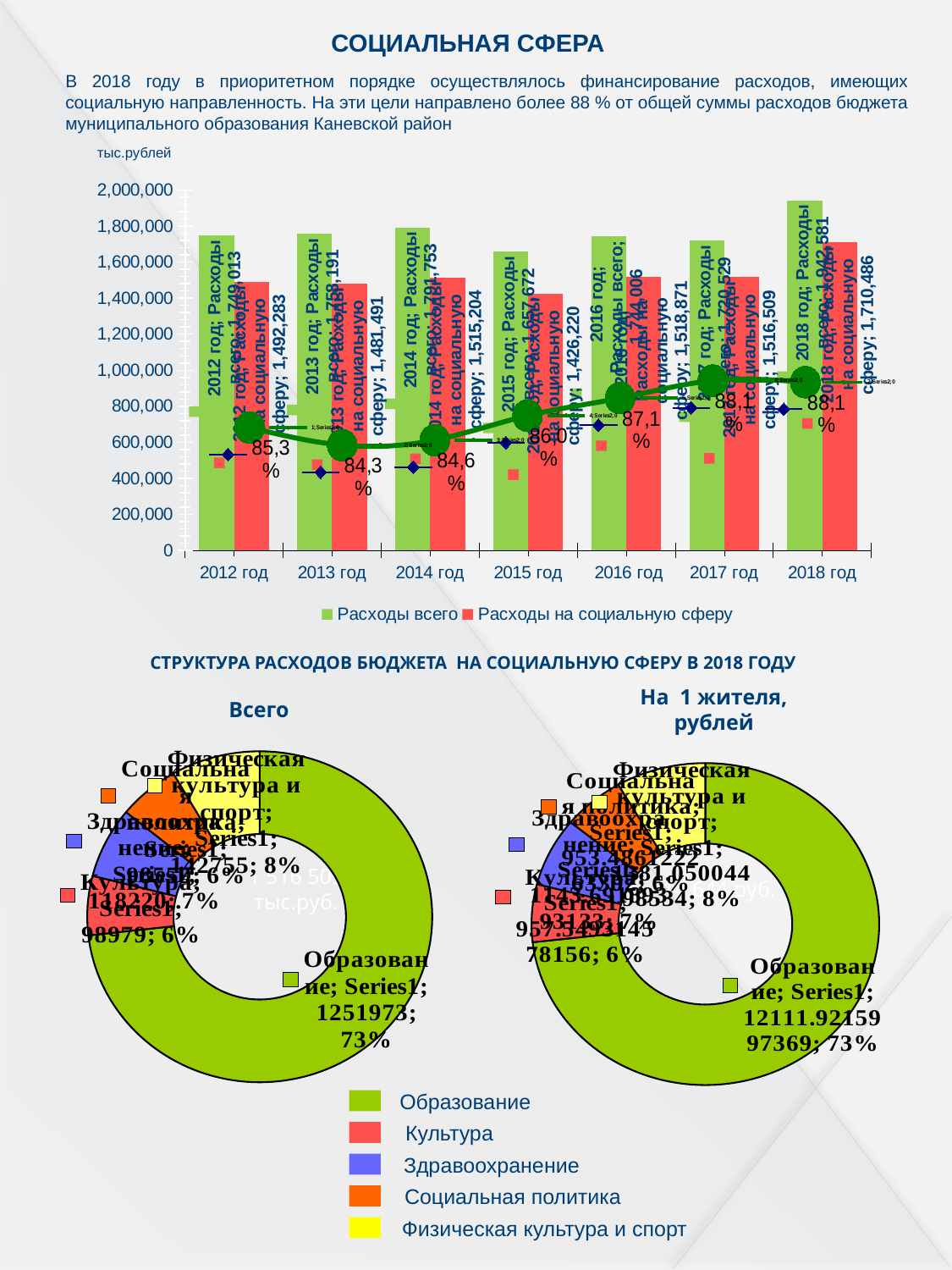
In the 'Всего' donut chart at the bottom left, what share does Образование have? 73% In the top bar chart, which year has the lowest value for Расходы всего? 2015 год In the top bar chart, what is the value of Расходы на социальную сферу for 2015 год? 1,426,220 In the top bar chart, what is the value of Расходы на социальную сферу for 2018 год? 1,710,486 In the top bar chart, does the percentage line rise or fall from 2014 год to 2018 год? rise In the top bar chart, which year has the highest value for Расходы всего? 2018 год In the top bar chart, which is larger: Расходы всего for 2018 год or Расходы всего for 2015 год? 2018 год In the top bar chart, how many years are shown on the x axis? 7 What kind of chart is the top chart showing Расходы всего and Расходы на социальную сферу by year? bar chart In the top bar chart, what percentage is shown on the line for 2012 год? 85,3 % In the top bar chart, is the value of Расходы всего for 2018 год greater or less than 1,800,000? greater In the top bar chart, how many series does the legend list? 2